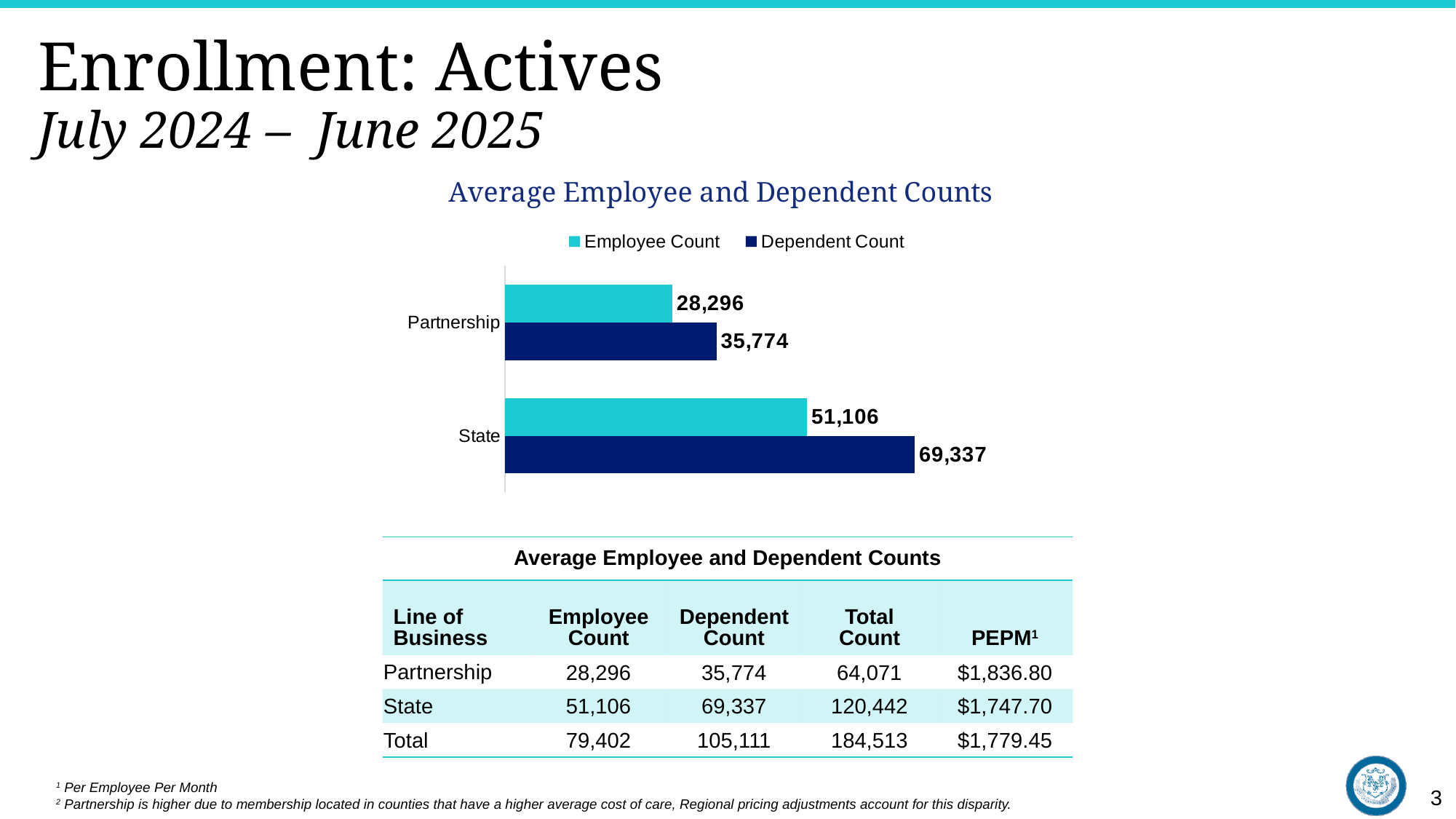
What is the Dependent Count for Partnership? 35,774 What is the title of the chart? Average Employee and Dependent Counts What kind of chart is shown? Bar chart How many categories are shown on the chart? 2 What is the Employee Count for Partnership? 28,296 How many series does the legend list? 2 What is the Dependent Count for State? 69,337 Which is larger for Partnership: the Employee Count or the Dependent Count? Dependent Count What is the difference between the State and Partnership Employee Counts? 22,810 What is the Employee Count for State? 51,106 Which category has the lowest Employee Count? Partnership Which category has the highest Dependent Count? State